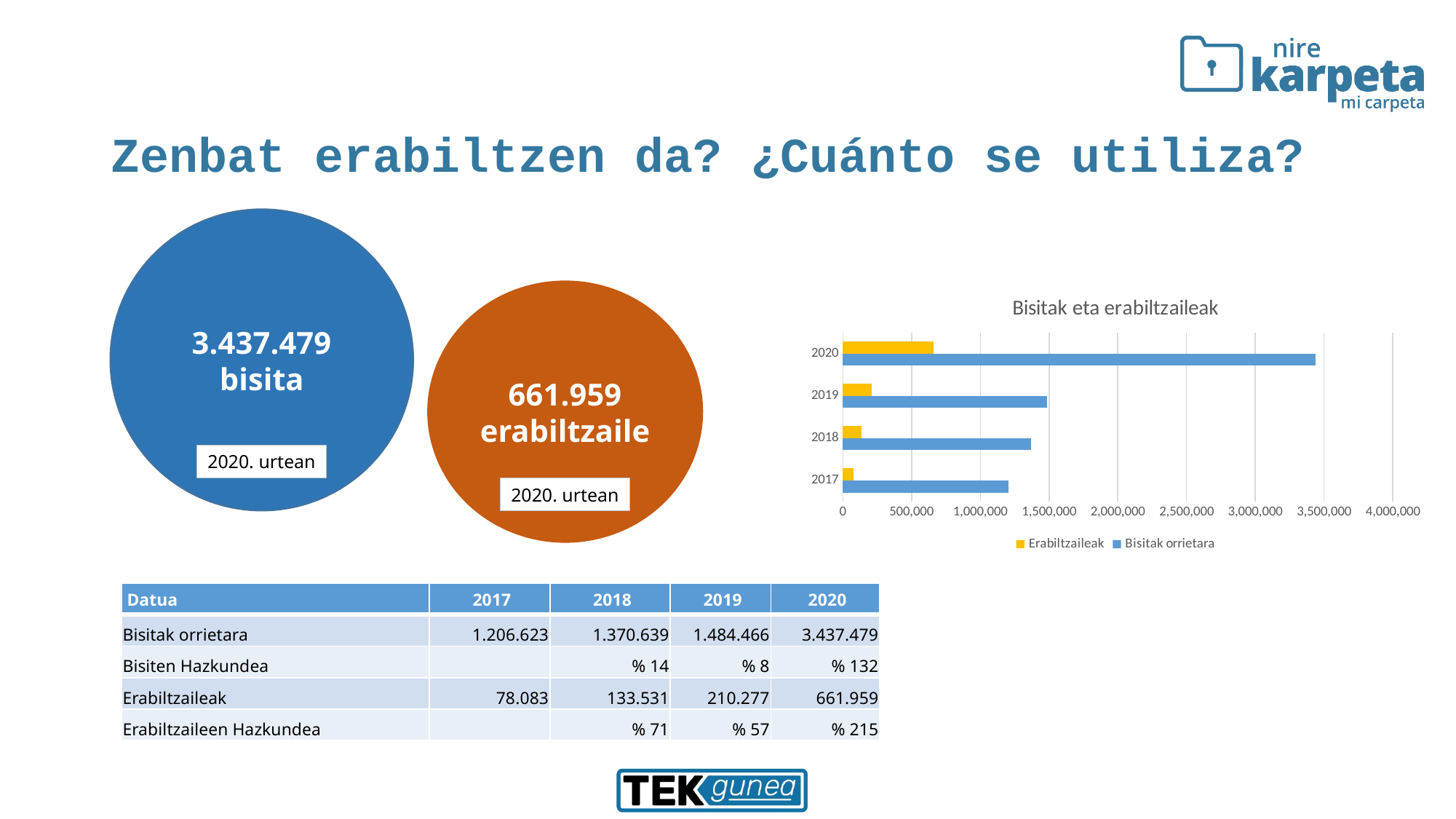
Do the Bisitak orrietara values rise or fall from 2017 to 2020? rise How many years (categories) are shown on the chart's vertical axis? 4 How many series does the chart legend list? 2 Is the Erabiltzaileak value for 2017 greater or less than 500,000? less In which year is the Bisitak orrietara bar the longest? 2020 Is the Erabiltzaileak value for 2020 greater or less than 500,000? greater Which is larger: the Erabiltzaileak bar for 2020 or the Bisitak orrietara bar for 2019? Bisitak orrietara for 2019 Is the Bisitak orrietara value for 2020 greater or less than 3,000,000? greater Which colour represents the Erabiltzaileak series in the chart? yellow What type of chart is shown on the slide? bar chart What is the title of the chart? Bisitak eta erabiltzaileak In which year is the Erabiltzaileak bar the shortest? 2017